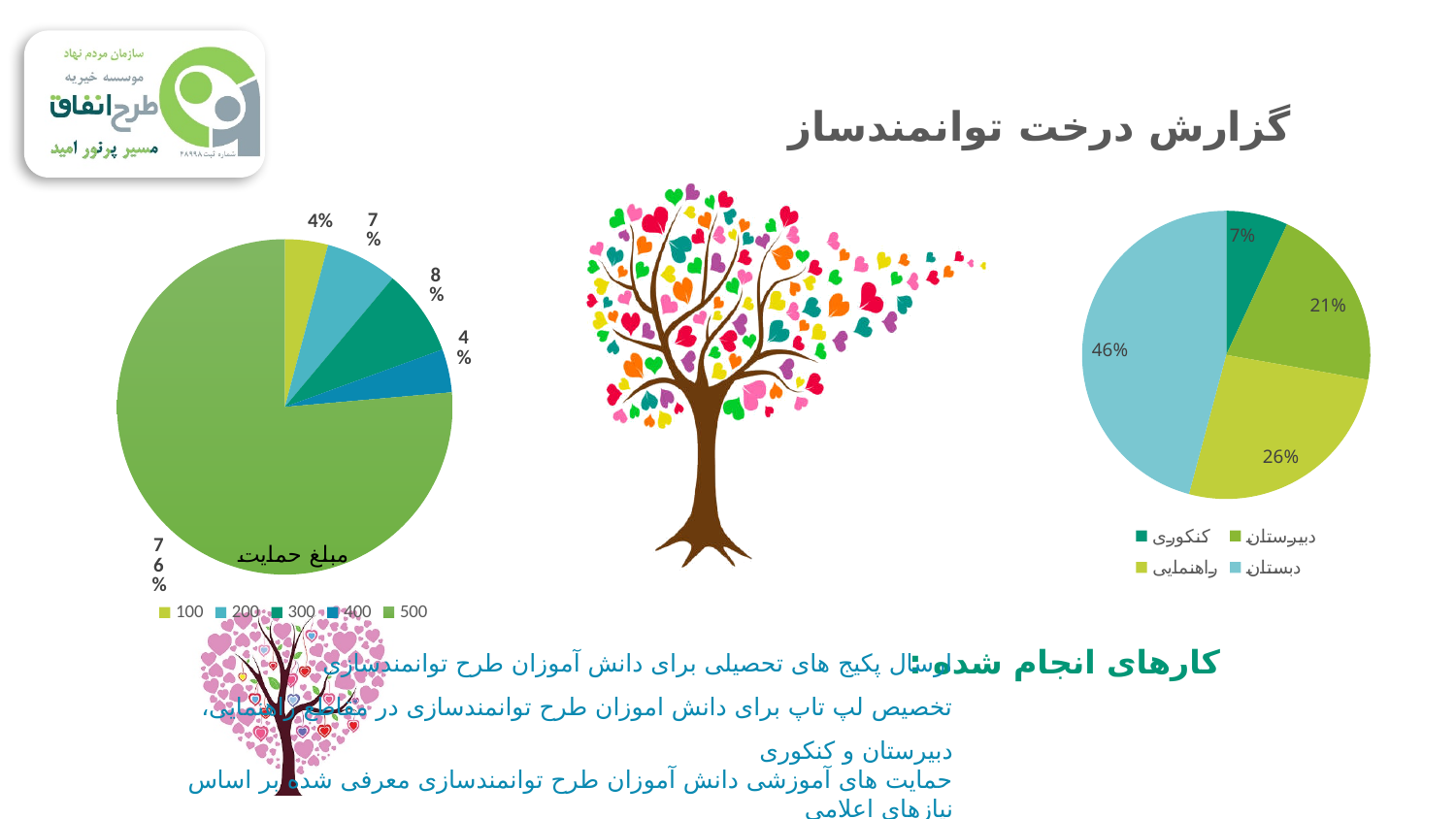
In the left pie chart titled مبلغ حمایت, what share does the 300 category have? 8% In the right pie chart, what share does دبستان have? 46% In the left pie chart titled مبلغ حمایت, what is the difference between the shares of 300 and 200? 1% In the left pie chart titled مبلغ حمایت, which category has the largest share? 500 In the right pie chart, what share does کنکوری have? 7% In the left pie chart titled مبلغ حمایت, what share does the 500 category have? 76% In the left pie chart titled مبلغ حمایت, how many categories does the legend list? 5 In the left pie chart titled مبلغ حمایت, what share does the 200 category have? 7% In the right pie chart, which category has the smallest share? کنکوری In the right pie chart, which is larger, دبیرستان or راهنمایی? راهنمایی In the right pie chart, what share does راهنمایی have? 26% What type of chart is the right chart on the slide? Pie chart